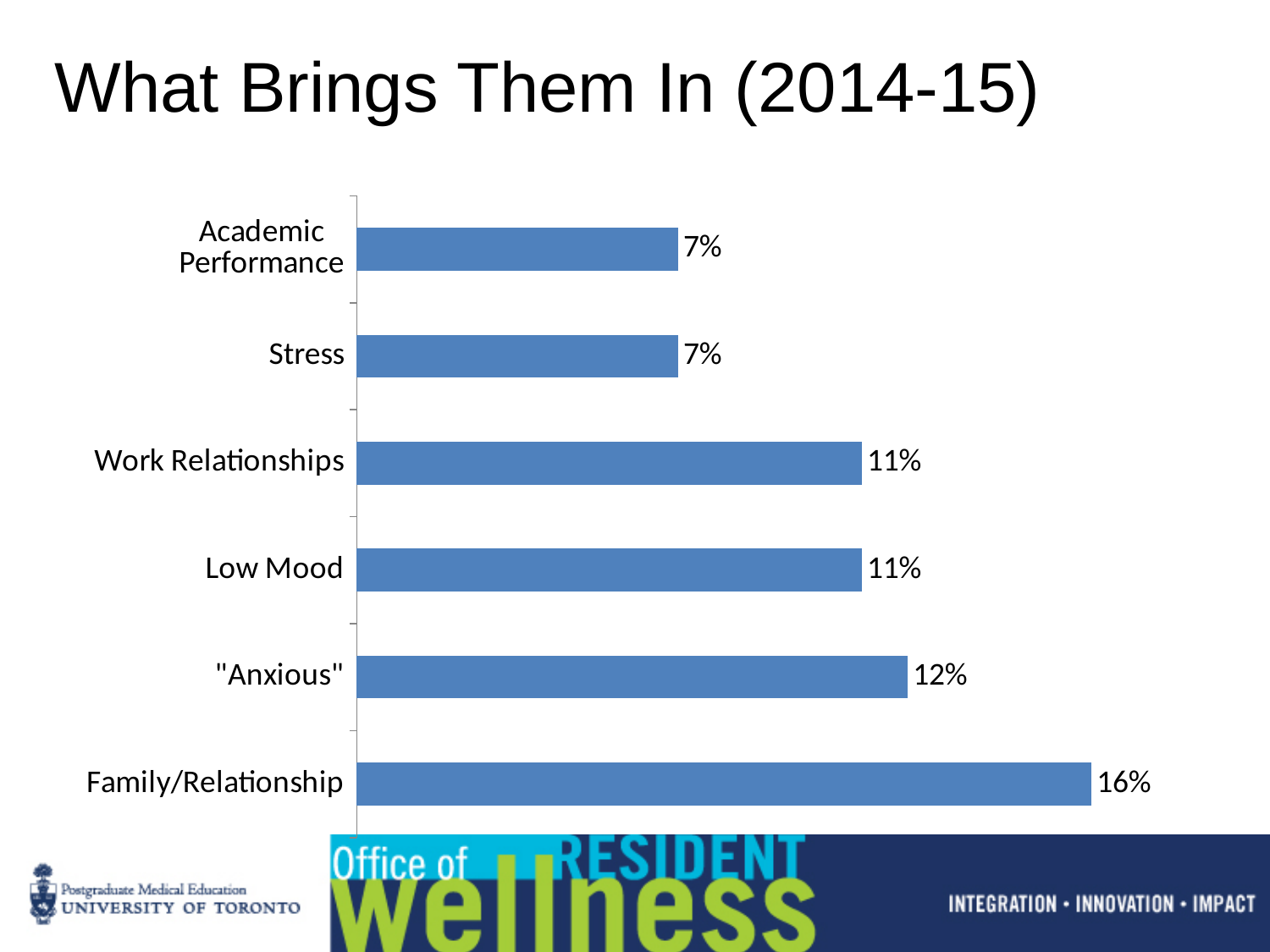
What is the value for "Anxious"? 12% Which two categories share the lowest value of 7%? Academic Performance and Stress Which category has the highest value? Family/Relationship What is the value for Work Relationships? 11% What is the value for Stress? 7% What is the value for Family/Relationship? 16% What is the difference between the values for Family/Relationship and "Anxious"? 4% How many categories are shown in the chart? 6 What kind of chart is shown on the slide? Bar chart Which is larger, the value for "Anxious" or the value for Stress? "Anxious" What is the difference between the values for Low Mood and Academic Performance? 4% What is the title of the slide containing the chart? What Brings Them In (2014-15)